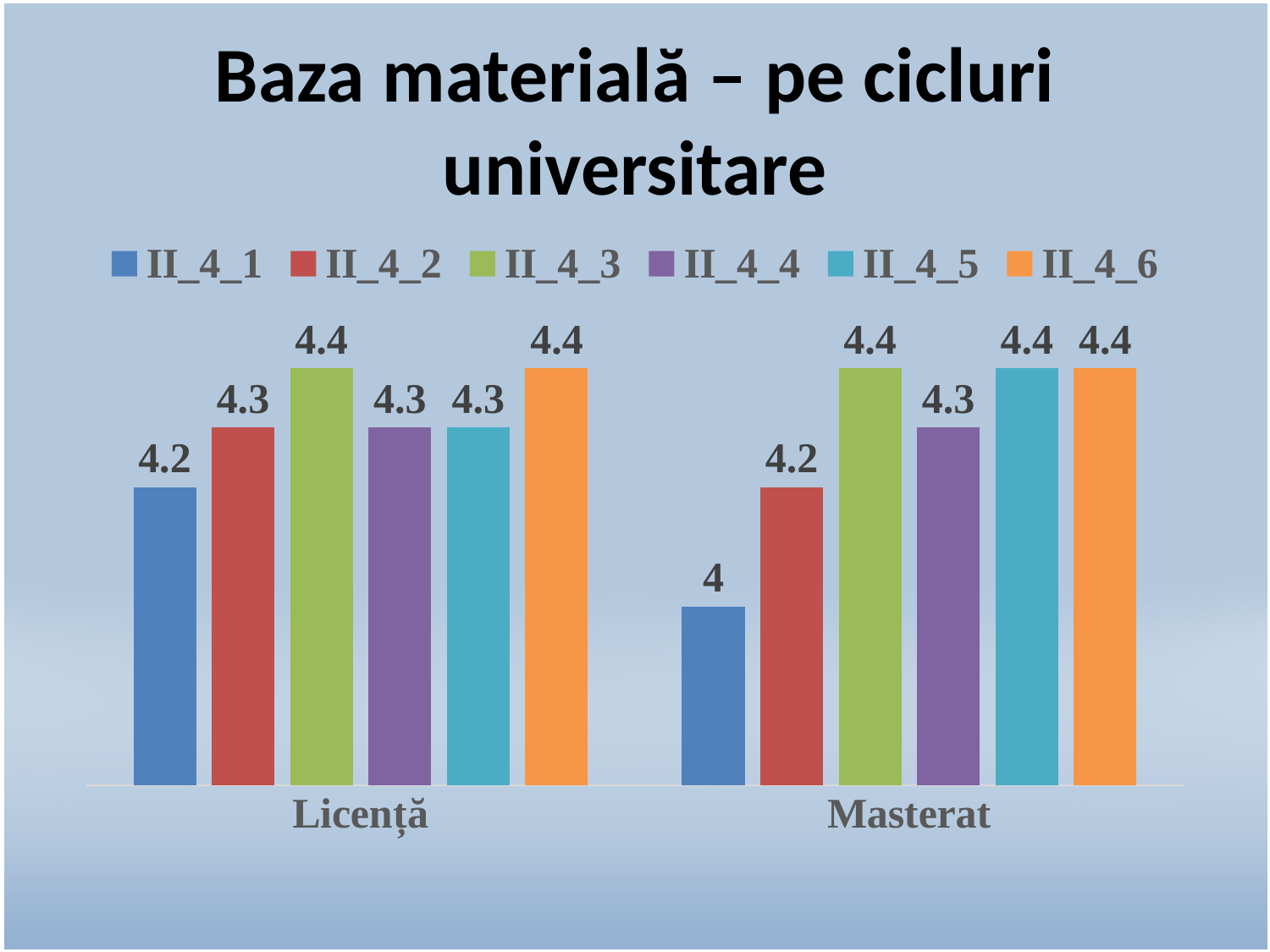
How many categories are shown on the x axis? 2 What is the value of II_4_2 for Masterat? 4.2 Which series has the lowest value for Masterat? II_4_1 What type of chart is shown on the slide? Bar chart What is the difference between II_4_3 and II_4_1 for Licență? 0.2 Which is larger, II_4_5 for Licență or II_4_5 for Masterat? II_4_5 for Masterat Which series has the lowest value for Licență? II_4_1 What is the value of II_4_1 for Masterat? 4 What is the value of II_4_1 for Licență? 4.2 What is the value of II_4_4 for Masterat? 4.3 What is the difference between the II_4_1 values for Licență and Masterat? 0.2 How many series does the legend list? 6